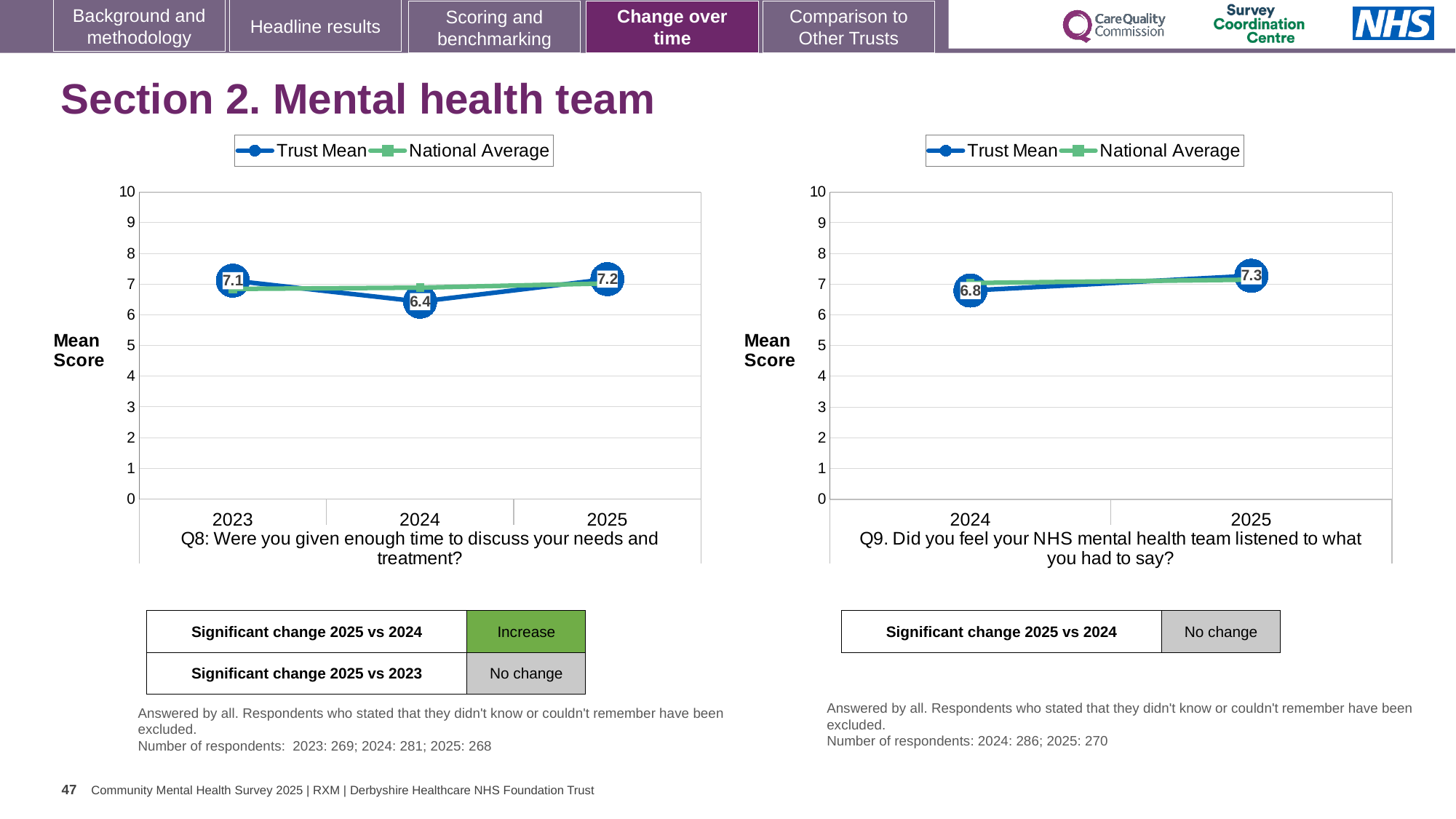
In the Q9 chart (right), does the Trust Mean rise or fall from 2024 to 2025? rise In the Q9 chart (right), what is the Trust Mean score for 2024? 6.8 In the Q8 chart (left), is the Trust Mean score for 2023 greater or less than 6? greater In the Q8 chart (left), what is the difference between the Trust Mean scores for 2025 and 2024? 0.8 In the Q8 chart (left), what is the Trust Mean score for 2024? 6.4 In the Q8 chart (left), what is the Trust Mean score for 2025? 7.2 In the Q9 chart (right), how many years are shown on the x axis? 2 In the Q8 chart (left), which year has the lowest Trust Mean score? 2024 In the Q9 chart (right), what is the Trust Mean score for 2025? 7.3 In the Q8 chart (left), how many series does the legend list? 2 In the Q8 chart (left), which year has the highest Trust Mean score? 2025 In the Q9 chart (right), what is the difference between the Trust Mean scores for 2025 and 2024? 0.5